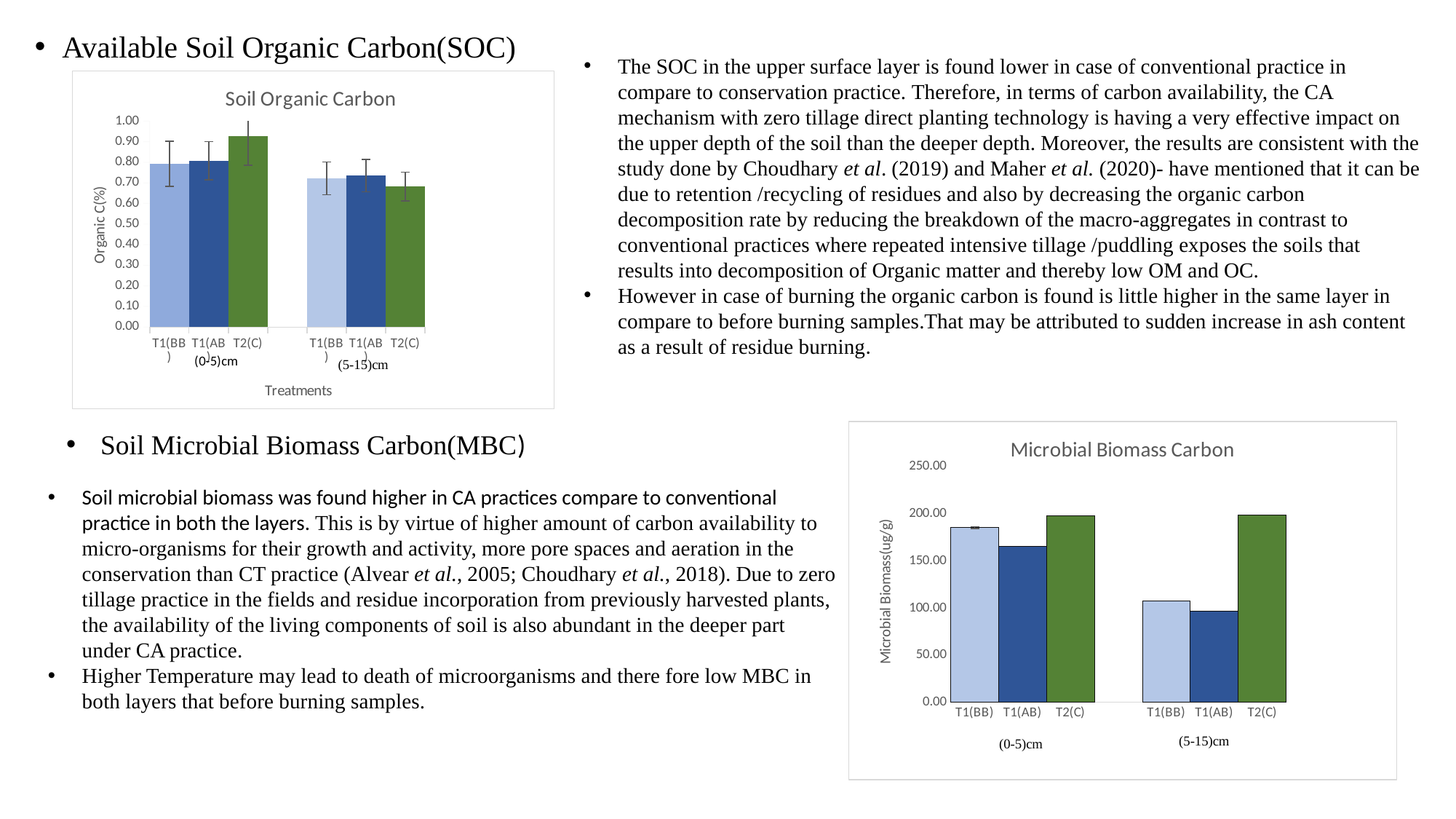
In the Soil Organic Carbon chart, how many bars are plotted in total? 6 In the Soil Organic Carbon chart, what kind of chart is used? bar chart In the Soil Organic Carbon chart, what is the label on the y axis? Organic C(%) In the Microbial Biomass Carbon chart, is the value for T1(AB) at (0-5)cm greater or less than 150.00? greater In the Soil Organic Carbon chart, which is larger: T2(C) at (0-5)cm or T2(C) at (5-15)cm? T2(C) at (0-5)cm In the Microbial Biomass Carbon chart, which is larger: T1(BB) at (0-5)cm or T1(BB) at (5-15)cm? T1(BB) at (0-5)cm In the Microbial Biomass Carbon chart, is the value for T1(AB) at (5-15)cm greater or less than 100.00? less In the Microbial Biomass Carbon chart, which treatment has the lowest microbial biomass value? T1(AB) at (5-15)cm In the Microbial Biomass Carbon chart, what kind of chart is used? bar chart In the Soil Organic Carbon chart, is the value for T2(C) at (5-15)cm greater or less than 0.70? less In the Soil Organic Carbon chart, which treatment has the highest organic carbon value? T2(C) at (0-5)cm